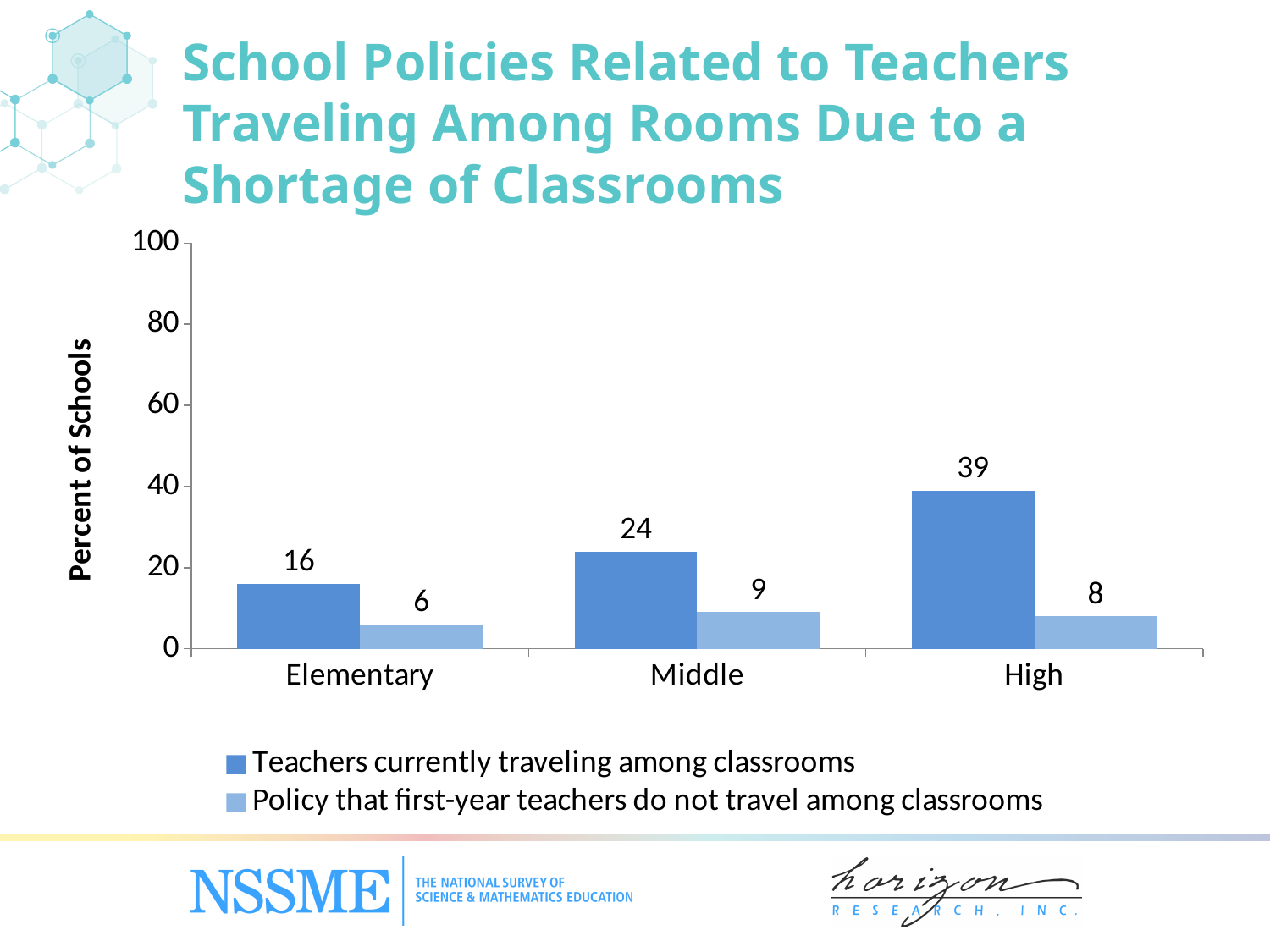
How many school levels are shown on the x axis? 3 Is the value for high schools with teachers currently traveling among classrooms greater or less than 20? greater For middle schools, which is larger: the percent with teachers currently traveling among classrooms or the percent with a policy that first-year teachers do not travel? Teachers currently traveling among classrooms Which school level has the highest percent of schools with teachers currently traveling among classrooms? High Which school level has the lowest percent of schools with a policy that first-year teachers do not travel among classrooms? Elementary What kind of chart is shown on the slide? Bar chart What percent of high schools have teachers currently traveling among classrooms? 39 Do the values for teachers currently traveling among classrooms rise or fall from Elementary to High? Rise What is the difference between the percent of high schools and elementary schools with teachers currently traveling among classrooms? 23 What percent of elementary schools have a policy that first-year teachers do not travel among classrooms? 6 What percent of middle schools have teachers currently traveling among classrooms? 24 How many series does the legend list? 2